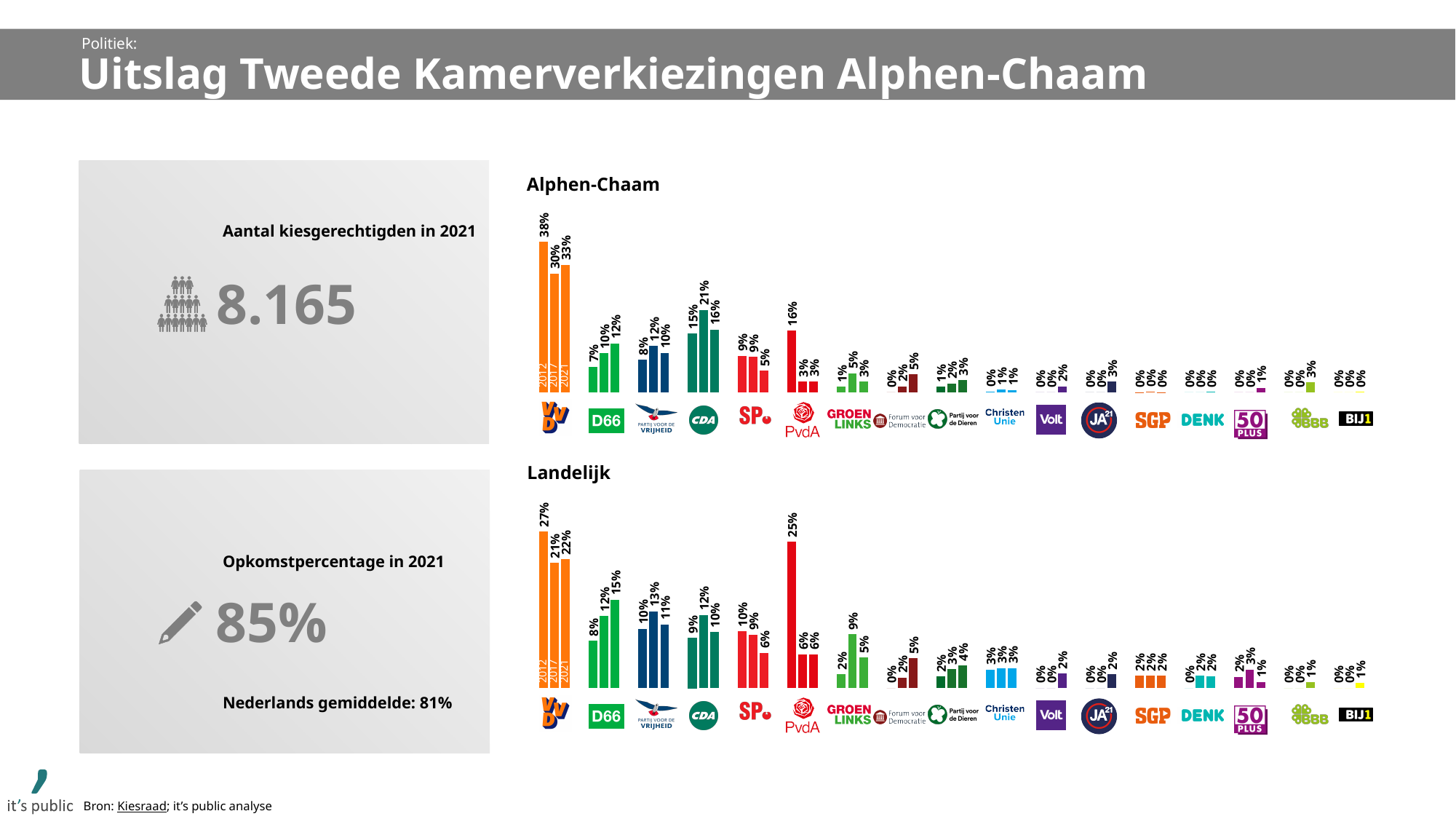
In the Alphen-Chaam chart, what is the difference between the VVD's 2012 and 2017 percentages? 8% In the Alphen-Chaam chart, what percentage did the CDA get in 2017? 21% In the Alphen-Chaam chart, which is larger: the CDA's 2021 value or the PVV's 2021 value? CDA's 2021 value In the Landelijk chart, do D66's values rise or fall from 2012 to 2021? rise In the Landelijk chart, what percentage did D66 get in 2021? 15% In the Alphen-Chaam chart, do the VVD's values rise or fall from 2012 to 2017? fall In the Landelijk chart, what is the difference between the PvdA's 2012 and 2017 percentages? 19% In the Landelijk chart, which party has the highest value in 2012? VVD In the Alphen-Chaam chart, which party has the highest value in 2021? VVD In the Landelijk chart, what percentage did the PvdA get in 2012? 25% In the Alphen-Chaam chart, what percentage did the VVD get in 2021? 33% What kind of chart is used for the Alphen-Chaam results? bar chart